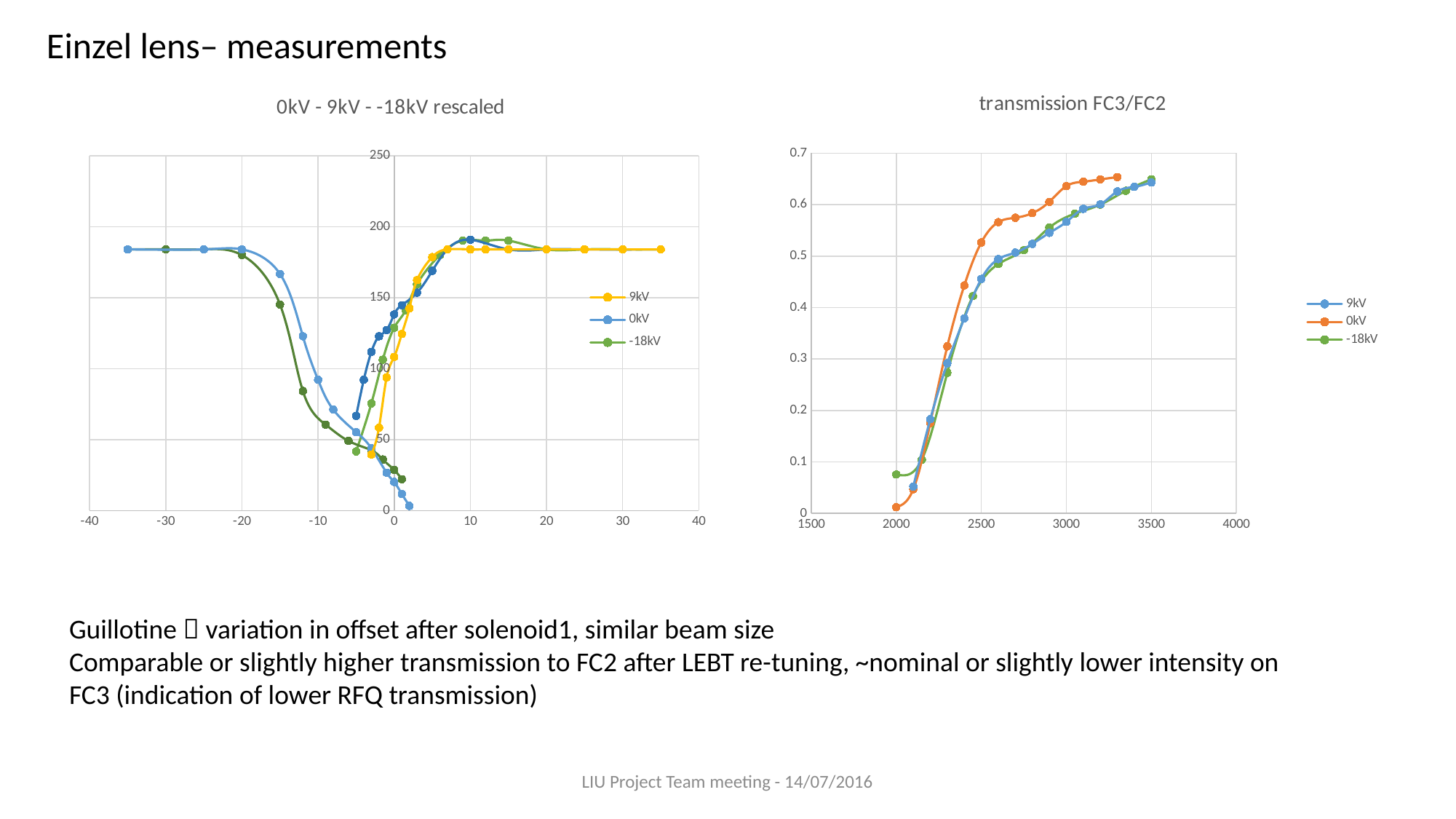
In the chart titled "0kV - 9kV - -18kV rescaled", is the value for -18kV at x = -10 greater or less than 100? less In the chart titled "transmission FC3/FC2", is the value for -18kV at x = 2000 greater or less than 0.1? less How many series does the legend of the chart titled "0kV - 9kV - -18kV rescaled" list? 3 How many series does the legend of the chart titled "transmission FC3/FC2" list? 3 In the chart titled "transmission FC3/FC2", is the value for 9kV at x = 2500 greater or less than 0.5? less What kind of chart is the chart titled "transmission FC3/FC2"? line chart In the chart titled "transmission FC3/FC2", which series has the larger value at x = 2500, 0kV or 9kV? 0kV What is the title of the chart on the left of the slide? 0kV - 9kV - -18kV rescaled What are the legend entries of the chart titled "transmission FC3/FC2"? 9kV, 0kV, -18kV In the chart titled "transmission FC3/FC2", do the values for 0kV rise or fall as x increases from 2000 to 3300? rise